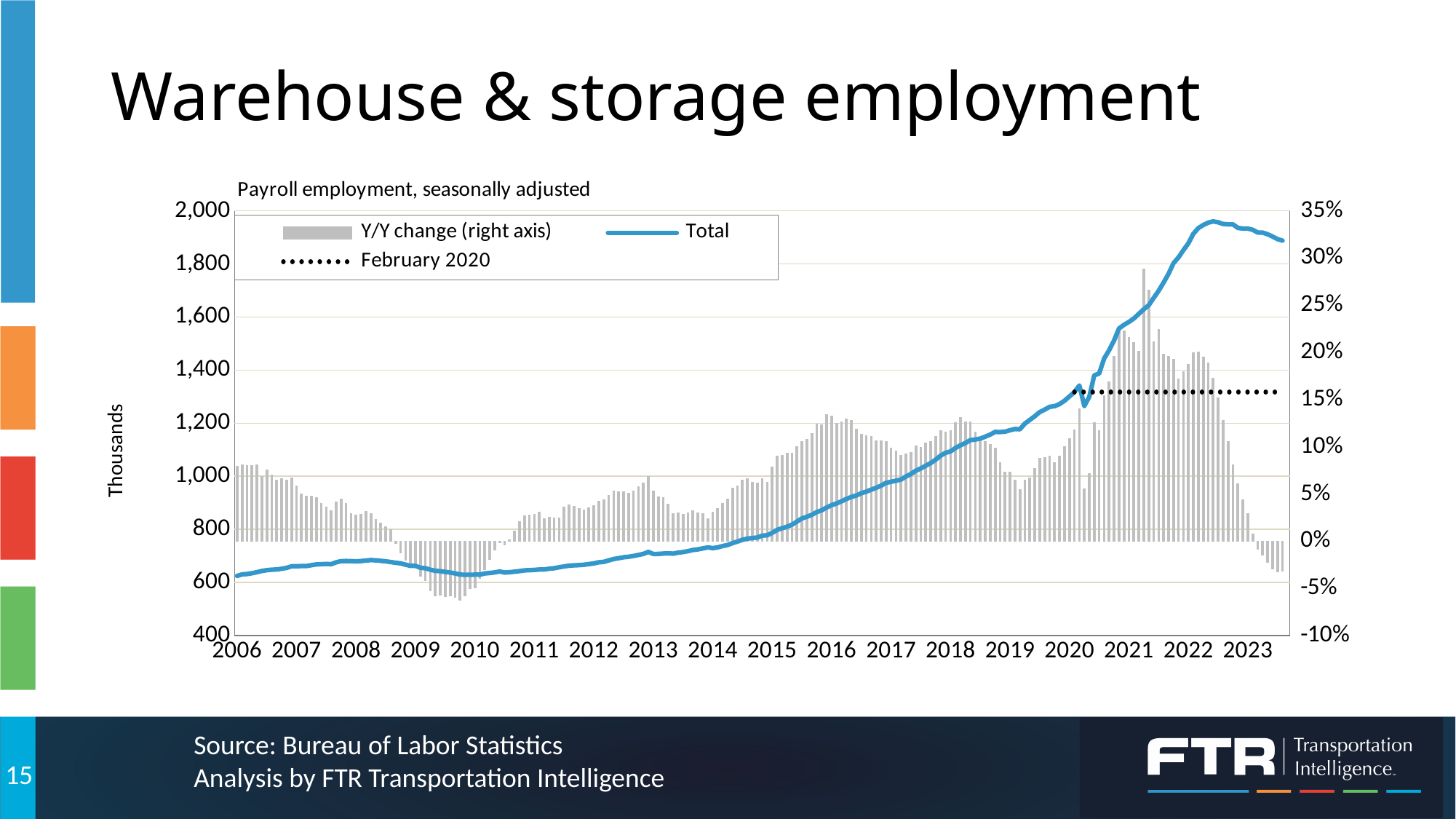
Does the Total line generally rise or fall from 2006 to 2023? rise Is the Y/Y change in late 2009 greater or less than 0%? less How many series does the legend list? 3 What unit is shown on the left vertical axis label? Thousands How many year labels are shown on the x axis? 18 What kind of chart is shown on the slide? A combination bar and line chart Is the Total value at the end of 2023 greater or less than 1,600? greater Is the Y/Y change at the end of 2023 greater or less than 0%? less Which series is plotted on the right axis according to the legend? Y/Y change